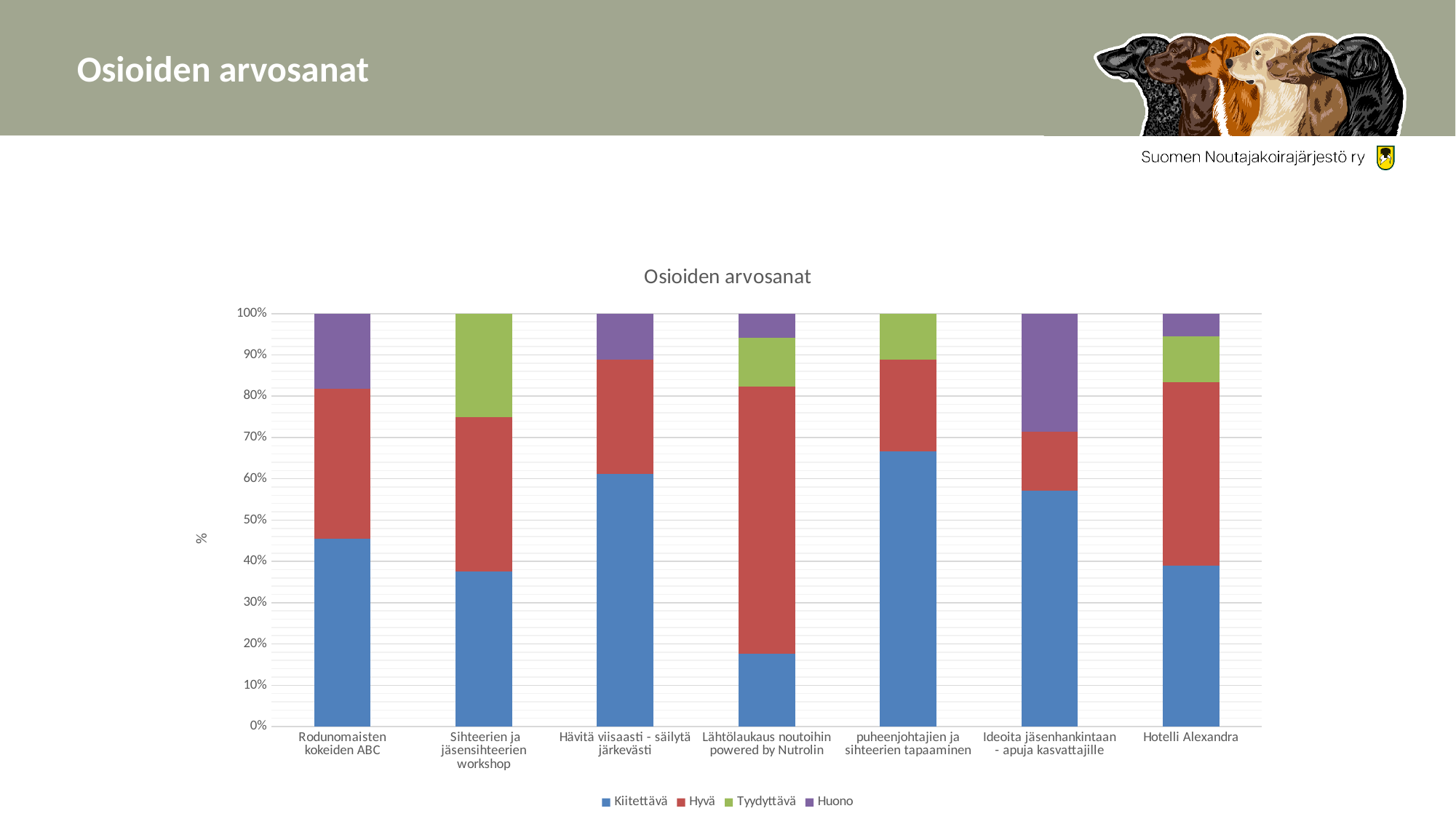
How many categories are shown on the x axis of the chart? 7 What kind of chart is shown on the slide? Stacked bar chart What is the total of the stacked bar for Hotelli Alexandra? 100% Which series is shown in blue in the chart? Kiitettävä Which category has the lowest Kiitettävä share? Lähtölaukaus noutoihin powered by Nutrolin Which category has the highest Kiitettävä share? puheenjohtajien ja sihteerien tapaaminen Which has a larger Kiitettävä share, Rodunomaisten kokeiden ABC or Sihteerien ja jäsensihteerien workshop? Rodunomaisten kokeiden ABC Is the Kiitettävä share for Hävitä viisaasti - säilytä järkevästi greater or less than 50%? greater Which category has the largest Huono share? Ideoita jäsenhankintaan - apuja kasvattajille How many series does the chart legend list? 4 What is the title of the chart? Osioiden arvosanat Is the Kiitettävä share for Lähtölaukaus noutoihin powered by Nutrolin greater or less than 30%? less